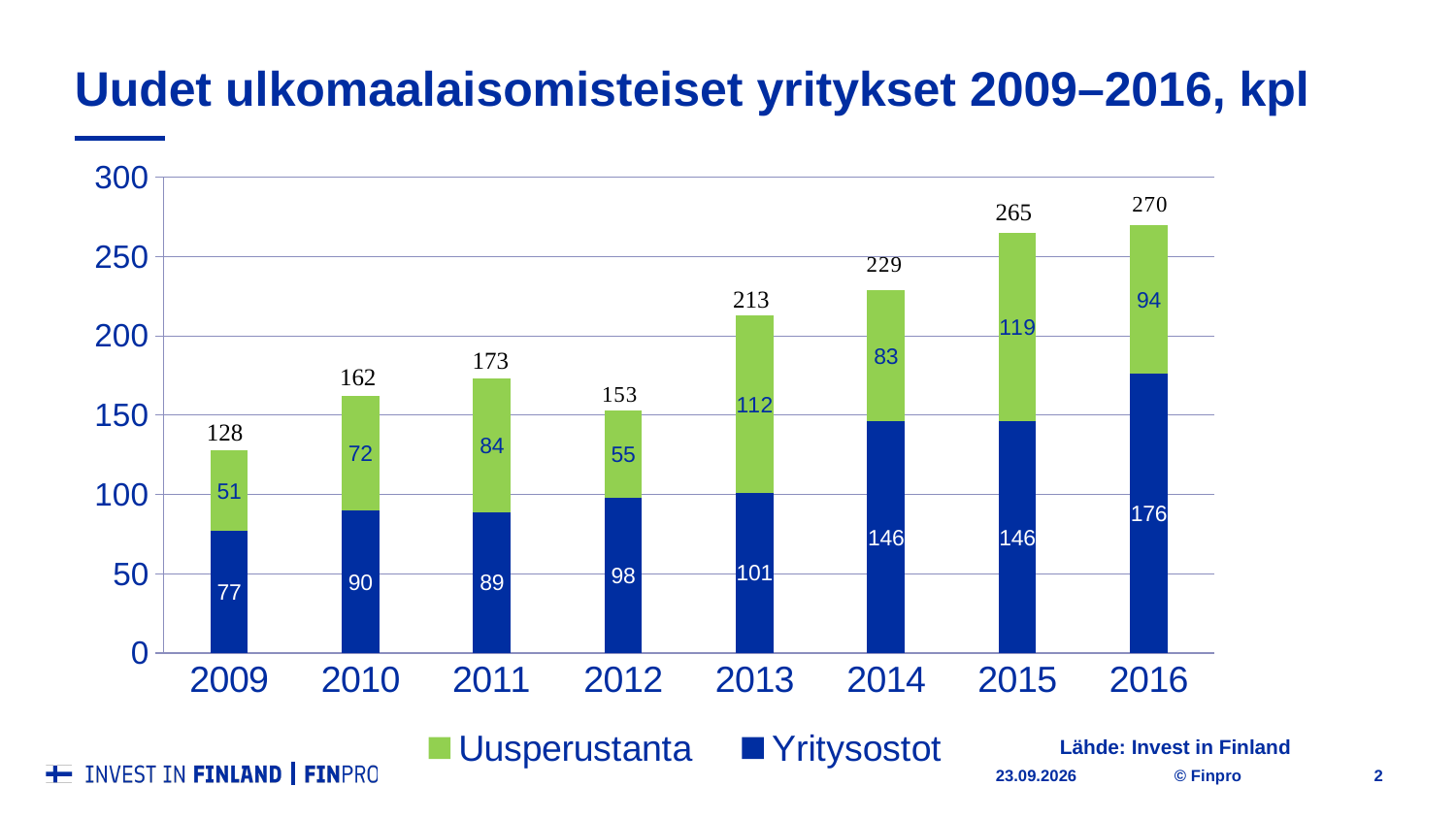
How many years are shown on the x axis? 8 Which series is shown in green in the legend? Uusperustanta What is the value for Uusperustanta in 2013? 112 What is the difference between the totals for 2015 and 2012? 112 Which year has the lowest total? 2009 Which year has the highest total? 2016 What kind of chart is shown on the slide? Stacked bar chart What is the total of the stacked bar for 2014? 229 How many series does the legend list? 2 Is the total for 2013 greater or less than 200? greater What is the value for Yritysostot in 2016? 176 Which is larger in 2011, Uusperustanta or Yritysostot? Yritysostot